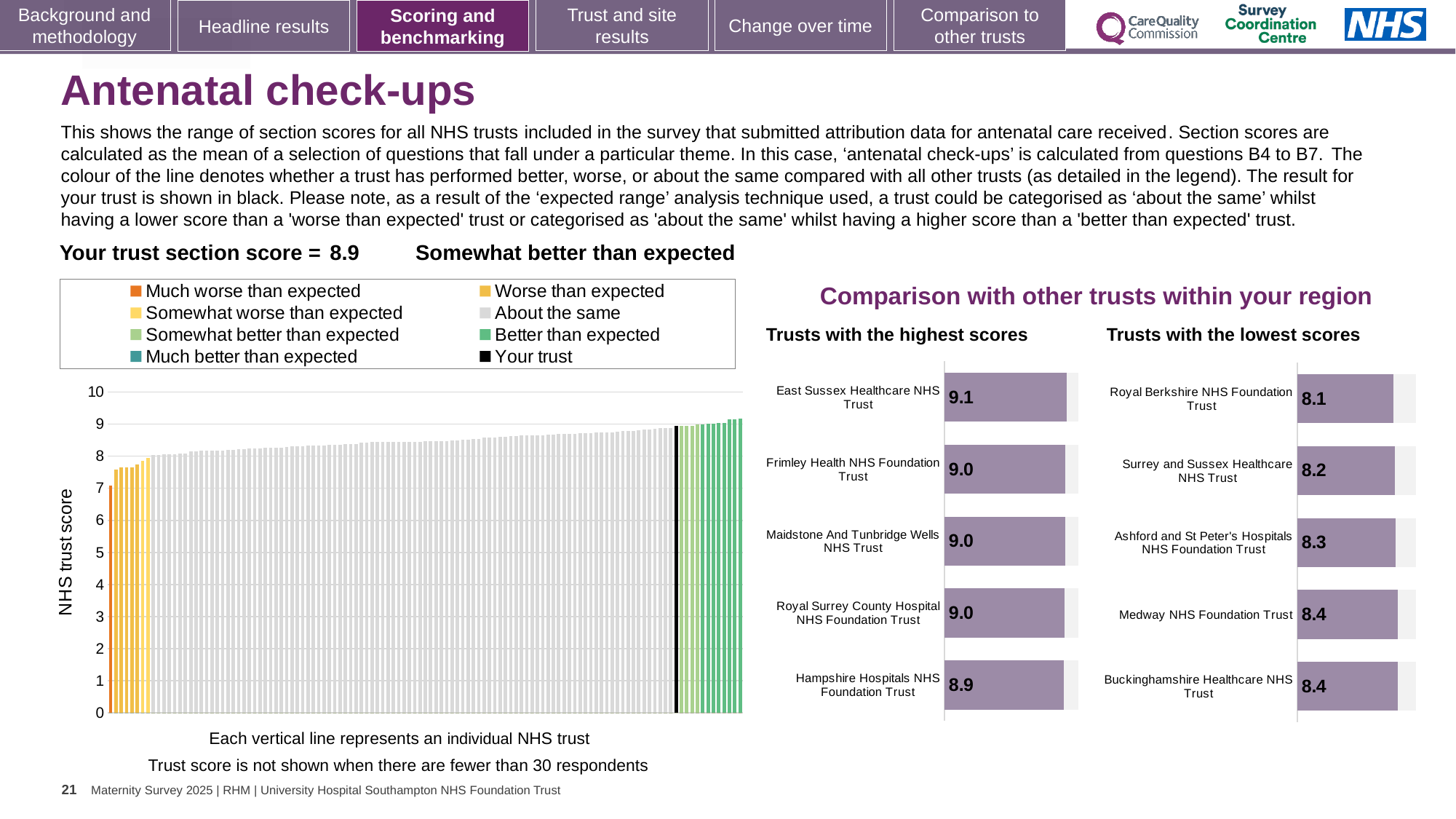
In the 'Trusts with the lowest scores' chart, which trust has the lowest score? Royal Berkshire NHS Foundation Trust In the 'NHS trust score' chart, is the value of the black 'Your trust' bar greater or less than 8? greater In the 'Trusts with the lowest scores' chart, what is the score for Ashford and St Peter's Hospitals NHS Foundation Trust? 8.3 In the 'Trusts with the highest scores' chart, what is the score for East Sussex Healthcare NHS Trust? 9.1 What kind of chart is the 'NHS trust score' chart on the left of the slide? bar chart How many entries does the legend of the 'NHS trust score' chart list? 8 In the 'Trusts with the lowest scores' chart, what is the difference between the scores of Buckinghamshire Healthcare NHS Trust and Royal Berkshire NHS Foundation Trust? 0.3 In the 'Trusts with the highest scores' chart, what is the difference between the scores of East Sussex Healthcare NHS Trust and Hampshire Hospitals NHS Foundation Trust? 0.2 In the 'Trusts with the lowest scores' chart, which has the higher score: Medway NHS Foundation Trust or Surrey and Sussex Healthcare NHS Trust? Medway NHS Foundation Trust How many trusts are shown in the 'Trusts with the highest scores' chart? 5 In the 'Trusts with the lowest scores' chart, what is the score for Royal Berkshire NHS Foundation Trust? 8.1 In the 'Trusts with the highest scores' chart, which trust has the highest score? East Sussex Healthcare NHS Trust